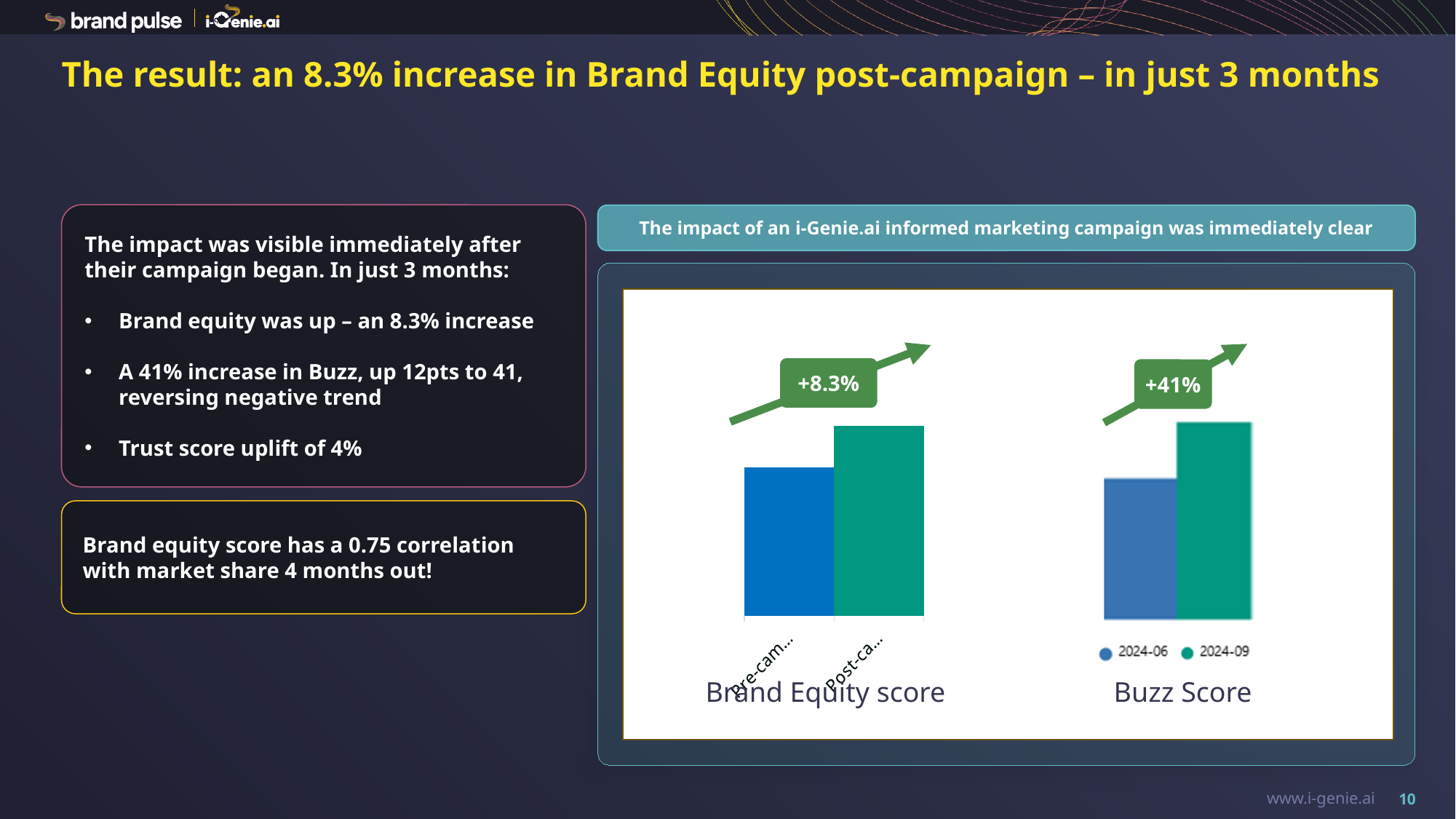
Do the bars in the Brand Equity score chart rise or fall from left to right? rise How many bars does the Brand Equity score chart show? 2 What kind of chart is the Buzz Score chart? bar chart In the Buzz Score chart, which bar is taller, 2024-06 or 2024-09? 2024-09 What kind of chart is the Brand Equity score chart? bar chart In the Brand Equity score chart, which bar is taller, the pre-campaign bar or the post-campaign bar? post-campaign How many bars does the Buzz Score chart show? 2 What percentage change is annotated above the Brand Equity score chart? +8.3% How many entries does the legend of the Buzz Score chart list? 2 In the Buzz Score chart, which period has the lowest bar? 2024-06 What percentage change is annotated above the Buzz Score chart? +41%